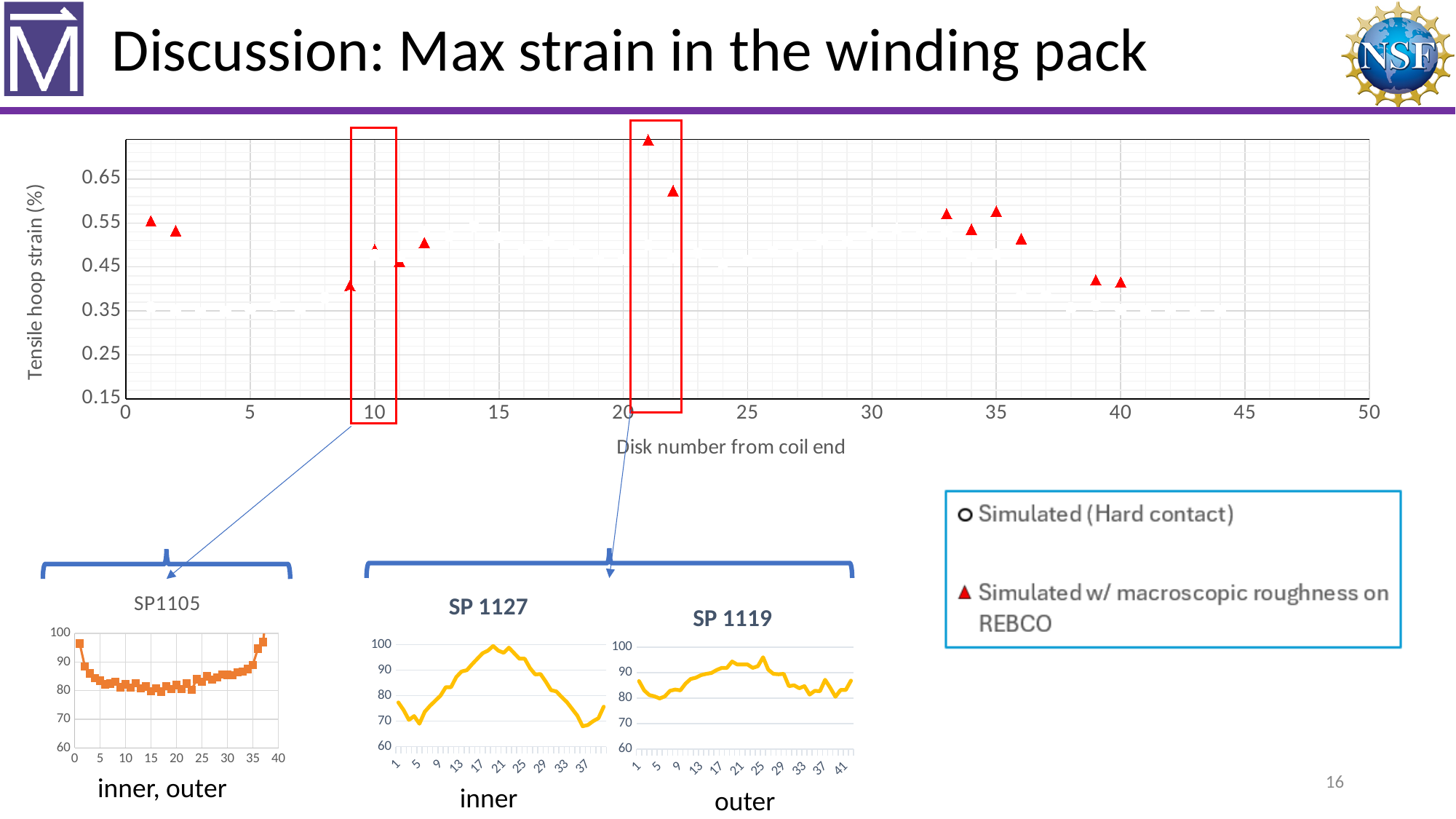
In the SP 1127 chart, do the values rise or fall between x = 1 and x = 21? rise In the SP 1119 chart, is the value at x = 1 greater or less than 80? greater How many series does the legend on the slide list? 2 In the main chart, which has the larger tensile hoop strain, disk 21 or disk 39? disk 21 In the main chart, at which disk number is the tensile hoop strain highest? 21 In the main chart, what is the highest value shown on the y axis? 0.65 In the main chart, is the tensile hoop strain at disk 40 greater or less than 0.45? less In the main chart, is the tensile hoop strain at disk 21 greater or less than 0.65? greater In the main chart, what is the label of the y axis? Tensile hoop strain (%) What kind of chart is the SP 1127 chart at the bottom of the slide? line chart In the main chart, what is the label of the x axis? Disk number from coil end